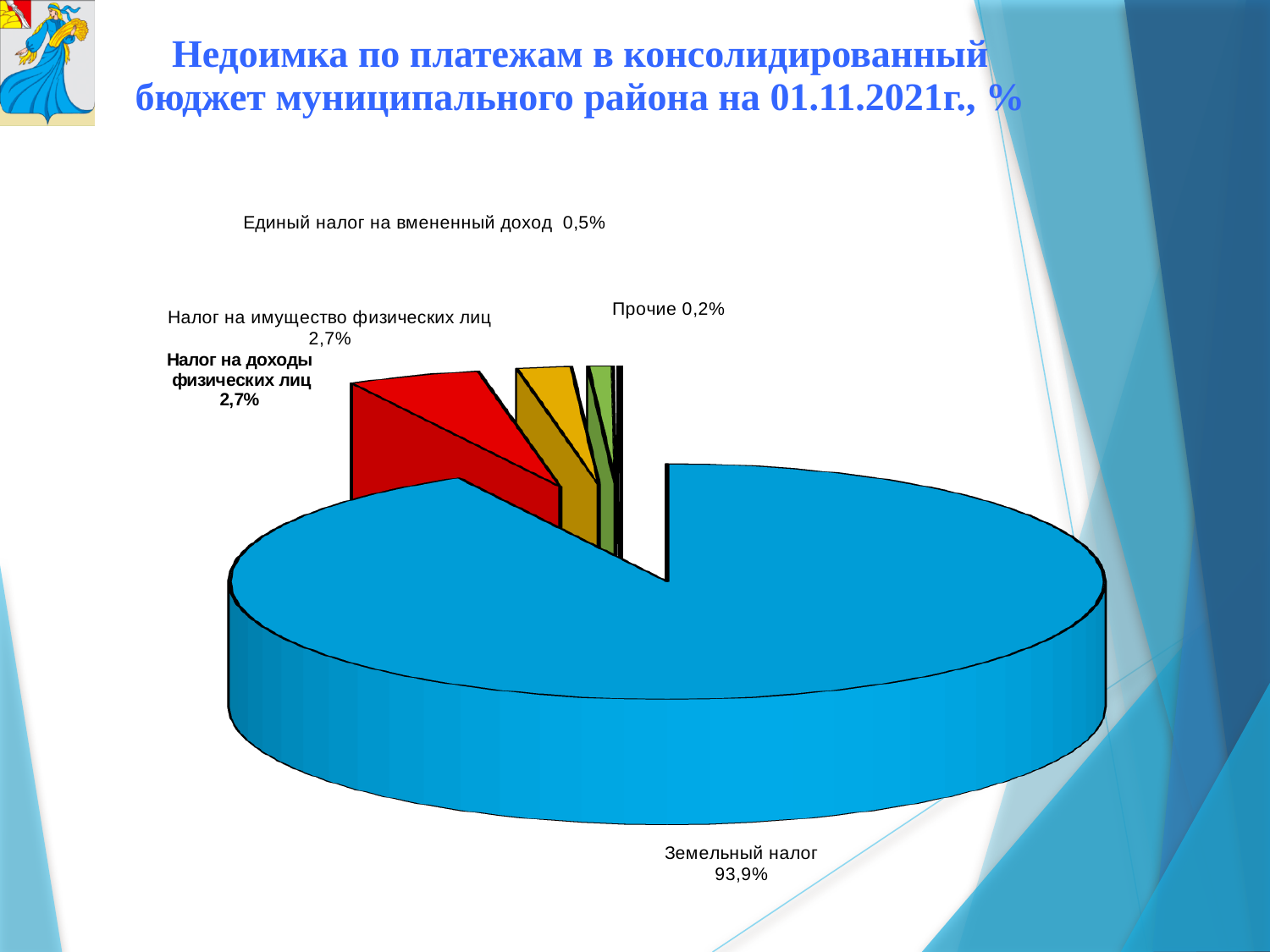
What is the value shown for Налог на доходы физических лиц? 2,7% How many slices does the pie chart have? 5 Which category has the smallest share of the pie? Прочие What kind of chart is shown on the slide? pie chart What is the value shown for Единый налог на вмененный доход? 0,5% Which category has the largest share of the pie? Земельный налог What share of the pie does Земельный налог have? 93,9% What is the difference between the share for Земельный налог and the share for Налог на имущество физических лиц? 91,2% What is the value shown for Налог на имущество физических лиц? 2,7% What is the title of the slide's chart? Недоимка по платежам в консолидированный бюджет муниципального района на 01.11.2021г., % What is the value shown for Прочие? 0,2% Which is larger, the share for Единый налог на вмененный доход or the share for Прочие? Единый налог на вмененный доход